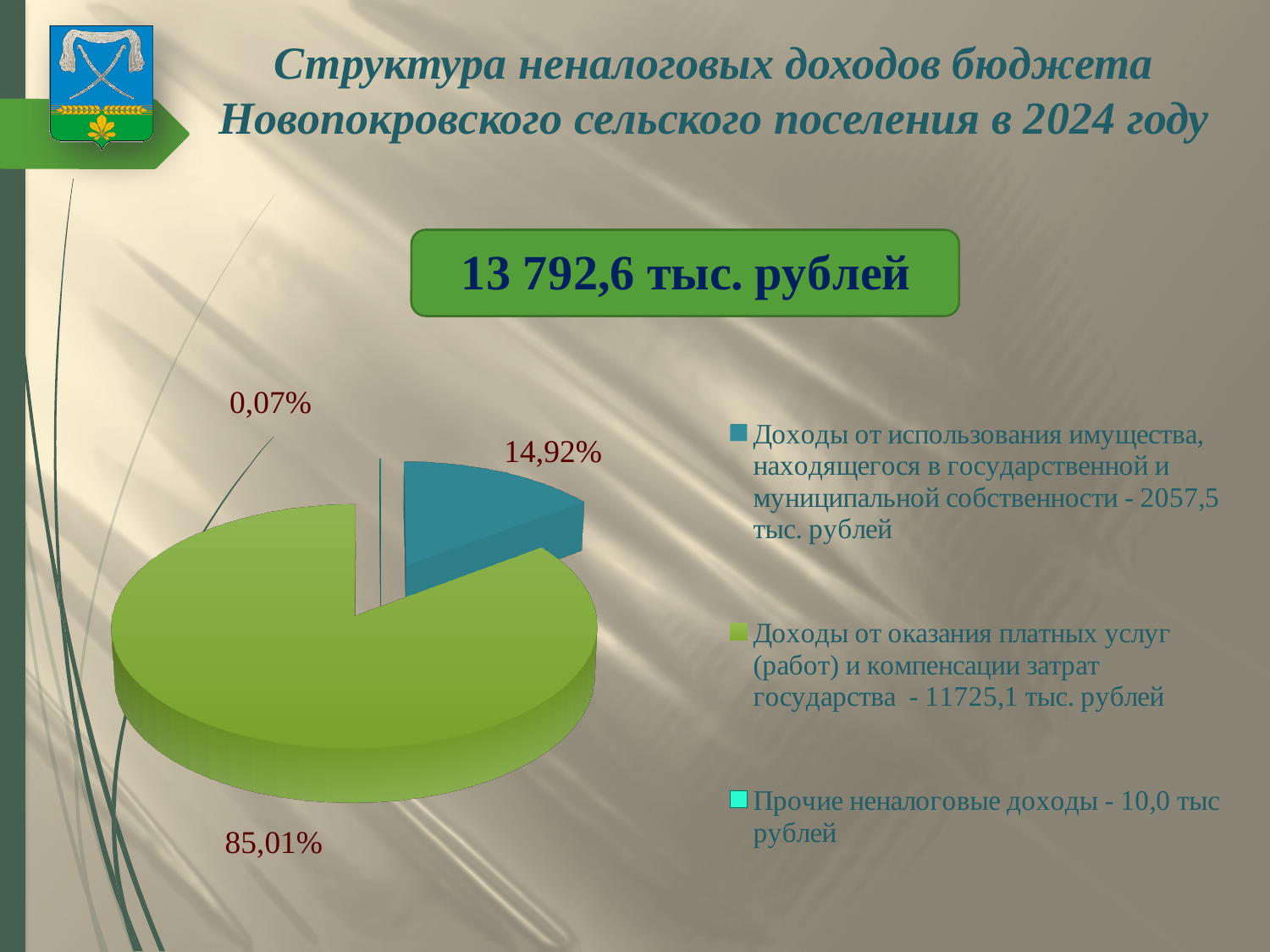
Which category has the largest slice of the pie? Доходы от оказания платных услуг (работ) и компенсации затрат государства What share of the pie does "Прочие неналоговые доходы" have? 0,07% What colour is the slice for "Доходы от оказания платных услуг (работ) и компенсации затрат государства"? green What is the value in тыс. рублей for "Прочие неналоговые доходы" according to the legend? 10,0 тыс рублей What is the difference in percentage points between the 85,01% slice and the 14,92% slice? 70,09 How many slices does the pie chart have? 3 What share of the pie does "Доходы от использования имущества, находящегося в государственной и муниципальной собственности" have? 14,92% How many entries does the legend of the pie chart list? 3 What is the value in тыс. рублей for "Доходы от использования имущества, находящегося в государственной и муниципальной собственности" according to the legend? 2057,5 тыс. рублей What type of chart is shown on the slide? pie chart What share of the pie does "Доходы от оказания платных услуг (работ) и компенсации затрат государства" have? 85,01% Which category has the smallest slice of the pie? Прочие неналоговые доходы